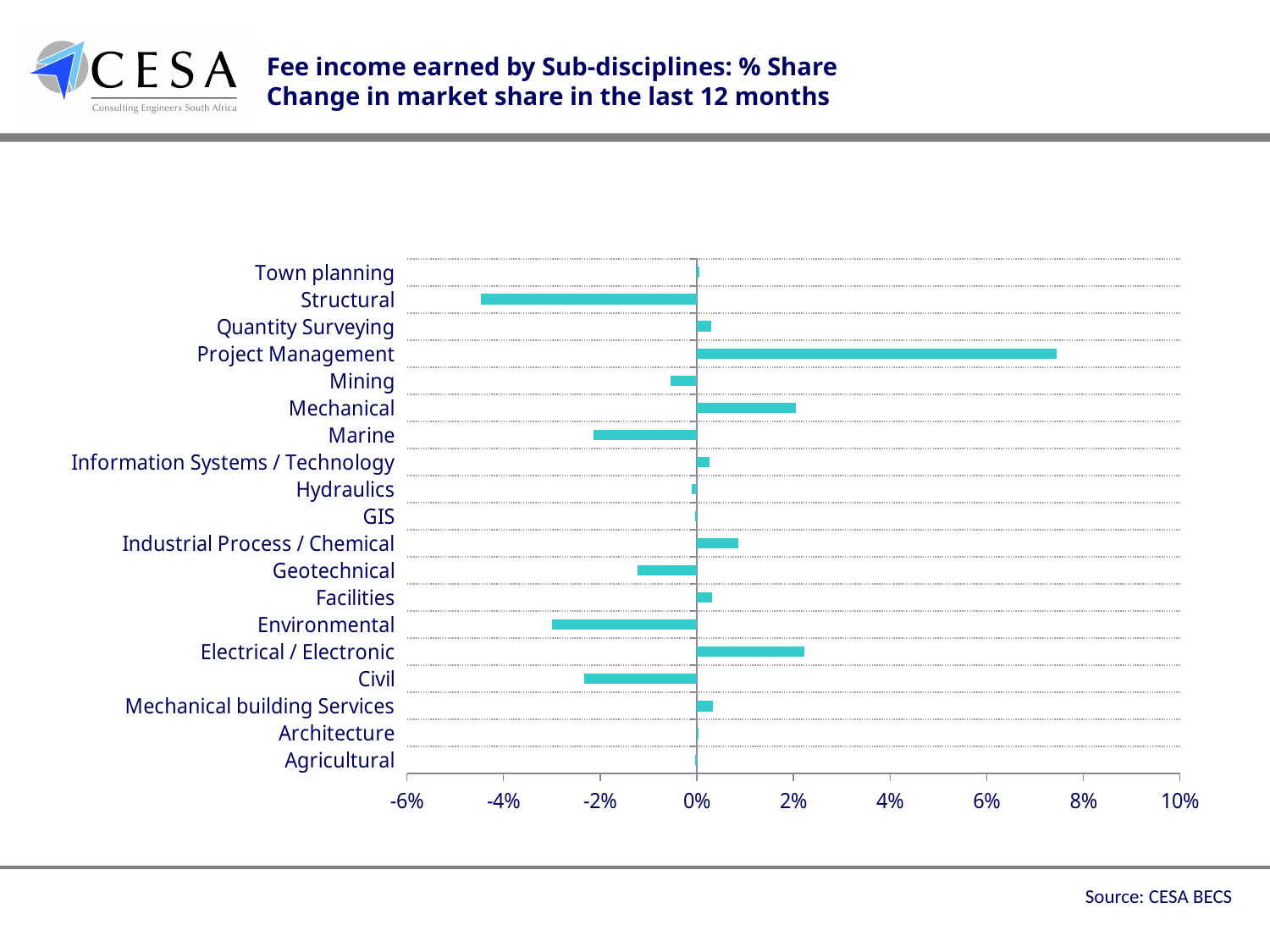
Is the value for Structural greater or less than -4%? less What kind of chart is shown on the slide? bar chart Is the value for Project Management greater or less than 6%? greater Is the value for Environmental greater or less than -2%? less Which sub-discipline has the lowest change in market share? Structural Which has the larger change in market share, Electrical / Electronic or Industrial Process / Chemical? Electrical / Electronic What is the source cited for the chart? CESA BECS Which has the larger change in market share, Project Management or Mechanical? Project Management Which sub-discipline has the highest change in market share? Project Management How many sub-disciplines are plotted on the chart? 19